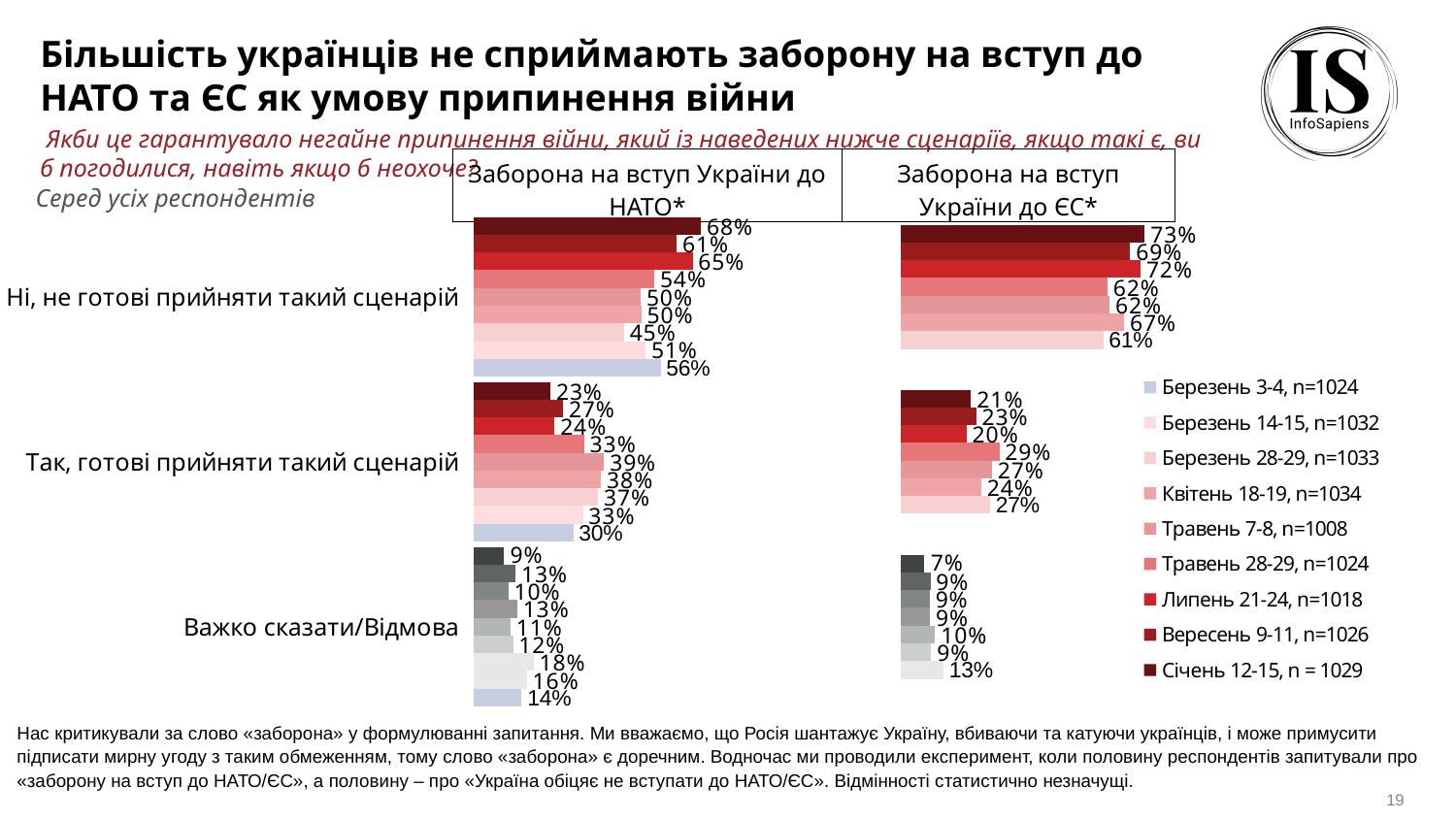
How many survey waves does the legend list? 9 What is the title of the right-hand chart? Заборона на вступ України до ЄС* In the chart 'Заборона на вступ України до НАТО*', what is the lowest value shown for 'Ні, не готові прийняти такий сценарій'? 45% In the chart 'Заборона на вступ України до НАТО*', what is the difference between 'Ні, не готові прийняти такий сценарій' (68%) and 'Так, готові прийняти такий сценарій' (23%) for the Січень 12-15 wave? 45 percentage points In the chart 'Заборона на вступ України до НАТО*', what is the value for 'Ні, не готові прийняти такий сценарій' in the Січень 12-15 wave (darkest bar)? 68% How many response categories are shown in each chart? 3 In the chart 'Заборона на вступ України до ЄС*', what is the value for 'Важко сказати/Відмова' in the Січень 12-15 wave (darkest bar)? 7% In the chart 'Заборона на вступ України до ЄС*', what is the value for 'Ні, не готові прийняти такий сценарій' in the Січень 12-15 wave (darkest bar)? 73% For the Січень 12-15 wave, which chart shows a higher share of 'Ні, не готові прийняти такий сценарій': the НАТО chart or the ЄС chart? The ЄС chart (73%) What kind of chart is used on this slide? Bar chart In the chart 'Заборона на вступ України до НАТО*', what is the value for 'Так, готові прийняти такий сценарій' in the Січень 12-15 wave (darkest bar)? 23% In the chart 'Заборона на вступ України до НАТО*', what is the highest value shown for 'Ні, не готові прийняти такий сценарій'? 68%